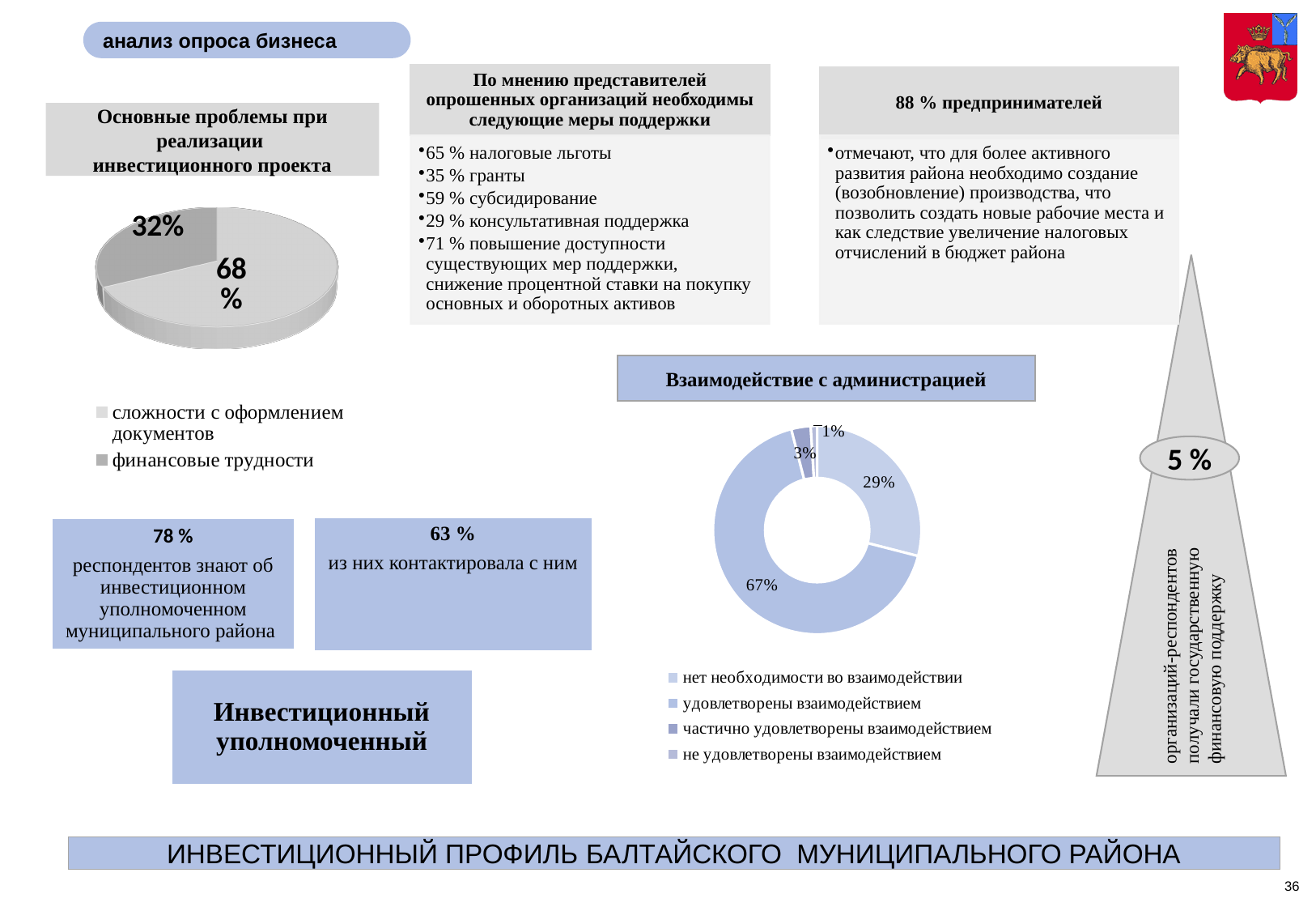
In the chart 'Взаимодействие с администрацией', what share is labelled for 'не удовлетворены взаимодействием'? 1% In the pie chart 'Основные проблемы при реализации инвестиционного проекта', what share is labelled for 'финансовые трудности'? 32% In the chart 'Взаимодействие с администрацией', what share is labelled for 'удовлетворены взаимодействием'? 67% How many categories does the legend of the pie chart 'Основные проблемы при реализации инвестиционного проекта' list? 2 What type of chart is shown under 'Основные проблемы при реализации инвестиционного проекта'? pie chart In the chart 'Взаимодействие с администрацией', which category has the smallest share? не удовлетворены взаимодействием In the pie chart 'Основные проблемы при реализации инвестиционного проекта', which category has the largest slice? сложности с оформлением документов In the chart 'Взаимодействие с администрацией', what share is labelled for 'нет необходимости во взаимодействии'? 29% In the chart 'Взаимодействие с администрацией', which is larger: 'нет необходимости во взаимодействии' or 'частично удовлетворены взаимодействием'? нет необходимости во взаимодействии In the pie chart 'Основные проблемы при реализации инвестиционного проекта', what share is labelled for 'сложности с оформлением документов'? 68% How many categories does the legend of the chart 'Взаимодействие с администрацией' list? 4 In the pie chart 'Основные проблемы при реализации инвестиционного проекта', what is the difference in percentage points between the two slices? 36